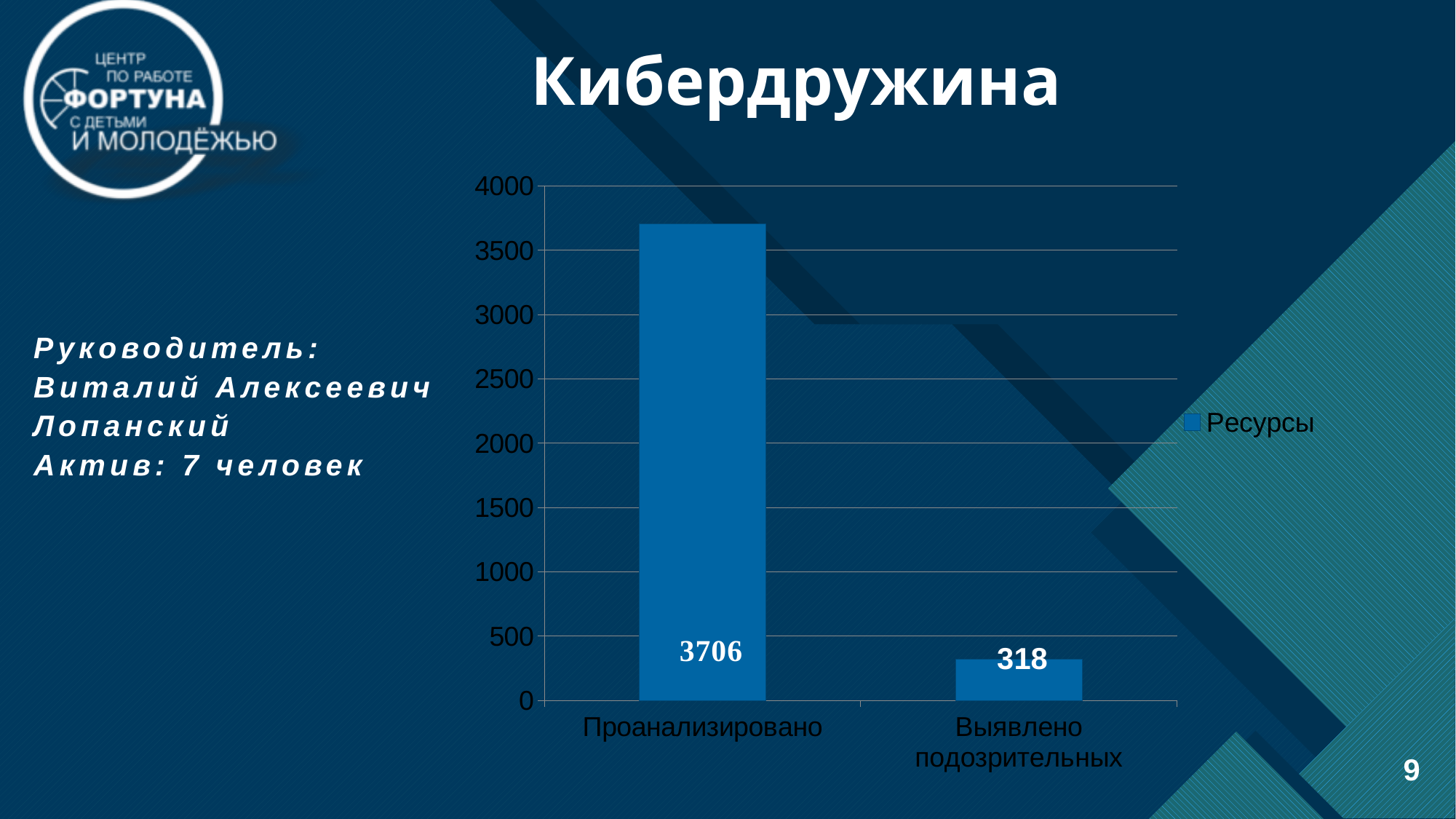
Which category has the lowest value? Выявлено подозрительных What is the name of the series in the legend? Ресурсы Which is larger, the value for Проанализировано or the value for Выявлено подозрительных? Проанализировано Which category has the highest value? Проанализировано What is the value for Выявлено подозрительных? 318 Is the value for Проанализировано greater or less than 3500? greater Is the value for Выявлено подозрительных greater or less than 500? less How many categories are shown on the x axis? 2 What is the value for Проанализировано? 3706 What kind of chart is shown on the slide? bar chart How many series does the legend list? 1 What is the difference between the values for Проанализировано and Выявлено подозрительных? 3388